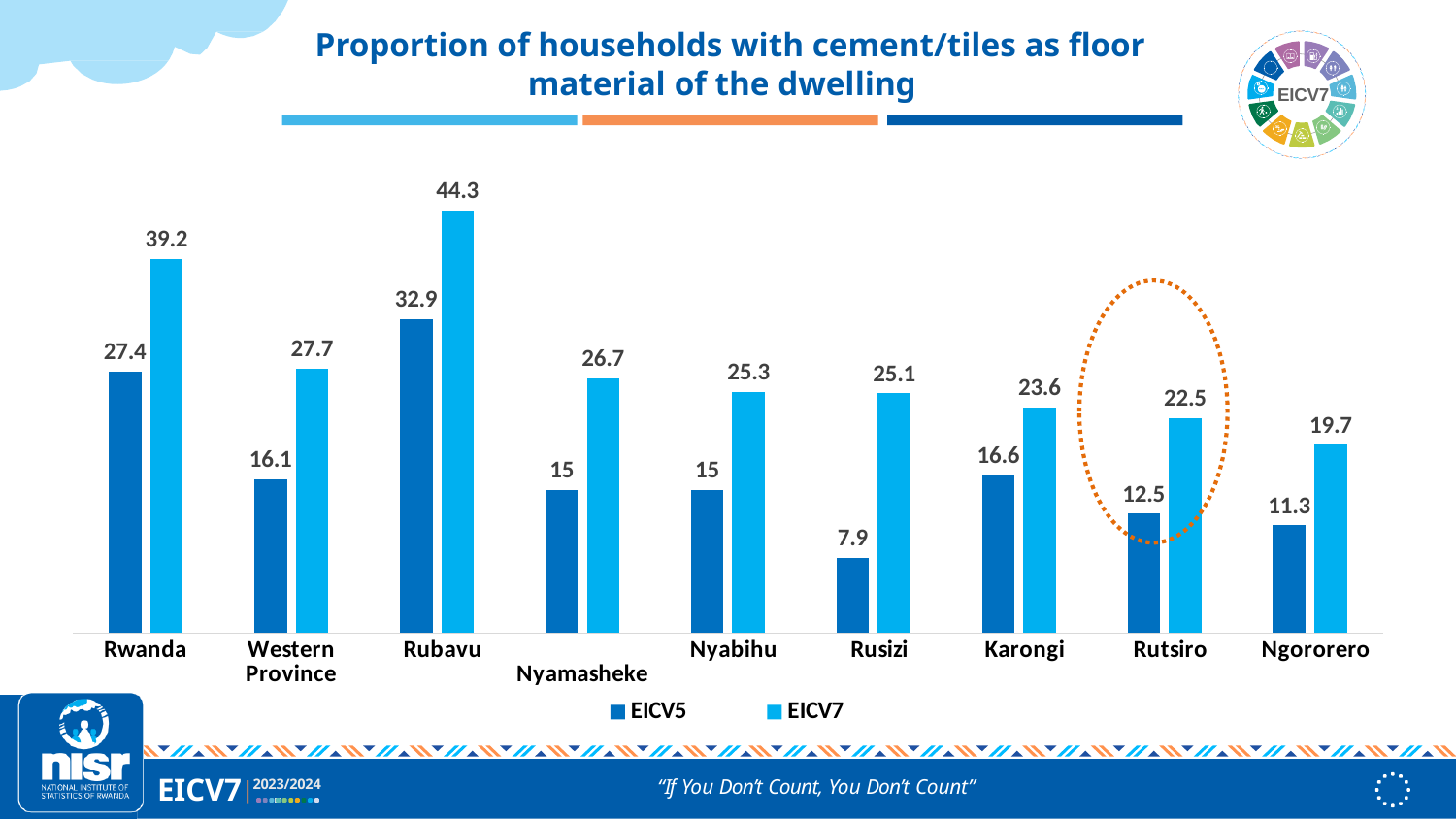
What is the EICV7 value for Rubavu? 44.3 What kind of chart is shown on the slide? Bar chart Which category has the highest EICV7 value? Rubavu What is the difference between the EICV7 and EICV5 values for Rwanda? 11.8 How many categories are shown on the x axis? 9 What is the EICV5 value for Rusizi? 7.9 Which is larger, the EICV7 value for Karongi or the EICV7 value for Nyabihu? Nyabihu What is the EICV5 value for Western Province? 16.1 Which category has the lowest EICV5 value? Rusizi How many series does the legend list? 2 Which category is highlighted with a dotted orange circle? Rutsiro What is the EICV7 value for Rutsiro? 22.5